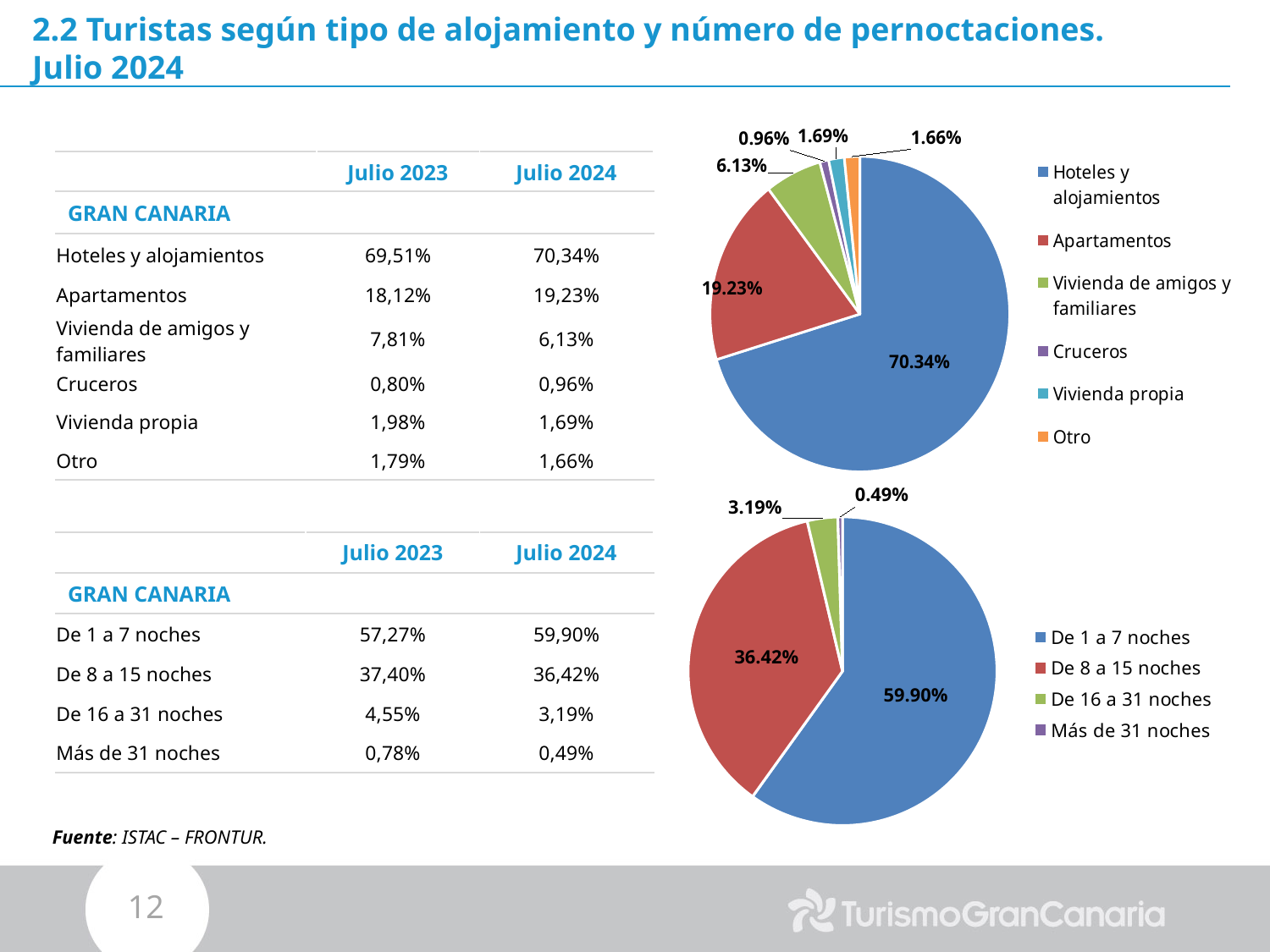
In the bottom pie chart (number of nights), is the slice for De 16 a 31 noches larger or smaller than the slice for De 8 a 15 noches? smaller In the bottom pie chart (number of nights), what share is shown for Más de 31 noches? 0.49% In the top pie chart (accommodation type), what is the difference between the Hoteles y alojamientos share and the Apartamentos share? 51.11% In the top pie chart (accommodation type), what share is shown for Apartamentos? 19.23% In the top pie chart (accommodation type), what share is shown for Cruceros? 0.96% In the bottom pie chart (number of nights), which category has the largest slice? De 1 a 7 noches In the top pie chart (accommodation type), which category has the smallest slice? Cruceros In the top pie chart (accommodation type), what share is shown for Hoteles y alojamientos? 70.34% In the bottom pie chart (number of nights), what share is shown for De 8 a 15 noches? 36.42% In the top pie chart (accommodation type), which category has the largest slice? Hoteles y alojamientos What type of chart is the bottom chart on the slide? pie chart In the top pie chart (accommodation type), how many categories does the legend list? 6